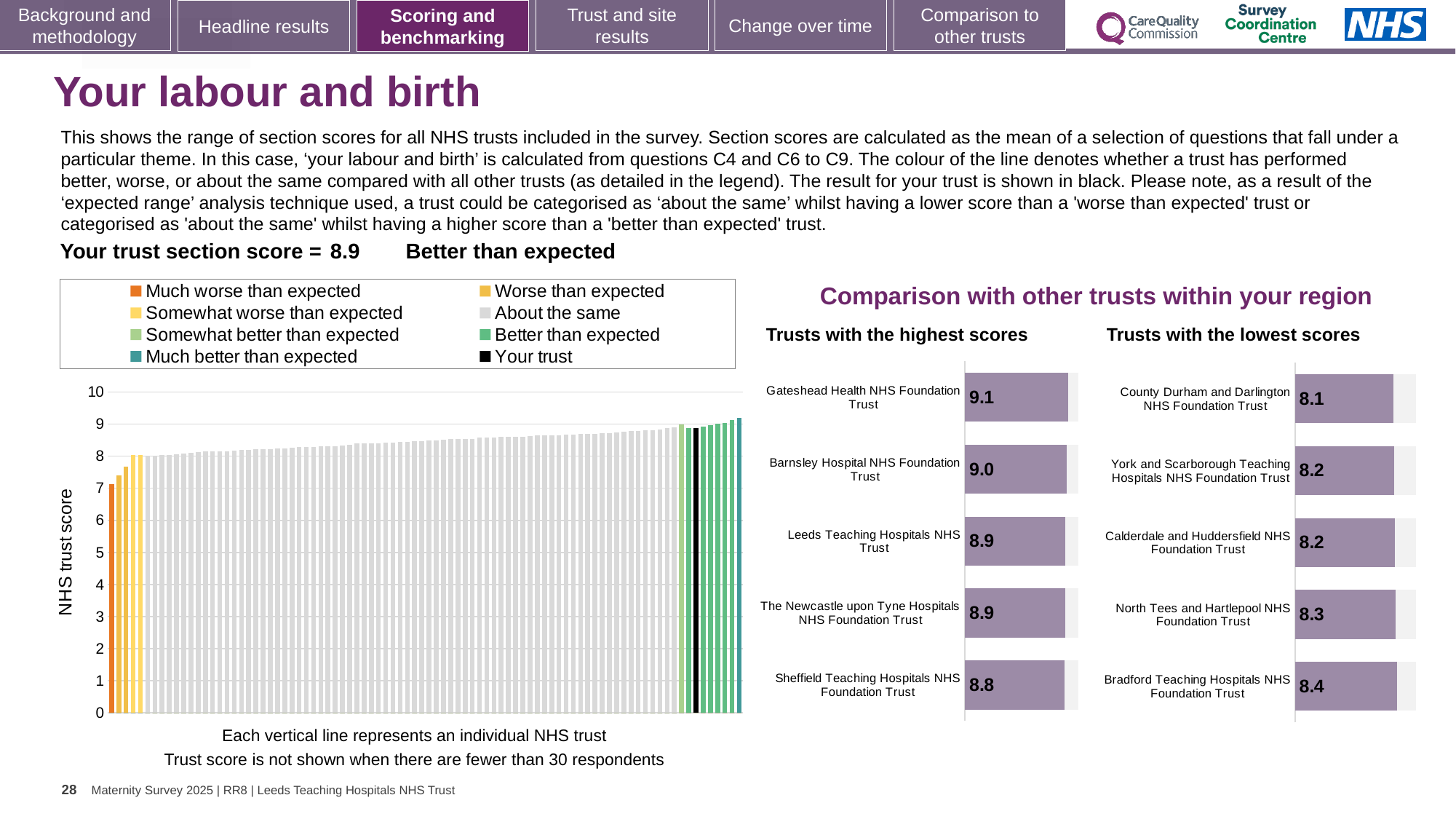
In the main chart on the left, do the trust scores rise or fall from left to right along the x axis? Rise In the 'Trusts with the lowest scores' chart, which trust has the lowest score? County Durham and Darlington NHS Foundation Trust In the 'Trusts with the highest scores' chart, which trust has the highest score? Gateshead Health NHS Foundation Trust In the 'Trusts with the lowest scores' chart, what is the score for Bradford Teaching Hospitals NHS Foundation Trust? 8.4 In the 'Trusts with the highest scores' chart, what is the difference between the scores of Gateshead Health NHS Foundation Trust and Sheffield Teaching Hospitals NHS Foundation Trust? 0.3 In the 'Trusts with the highest scores' chart, what is the score for Gateshead Health NHS Foundation Trust? 9.1 In the main chart on the left, is the value of the tallest bar greater or less than 9? greater What kind of chart is the main chart on the left showing all NHS trusts? Bar chart How many trusts are shown in the 'Trusts with the lowest scores' chart? 5 In the 'Trusts with the lowest scores' chart, which has the larger score: North Tees and Hartlepool NHS Foundation Trust or County Durham and Darlington NHS Foundation Trust? North Tees and Hartlepool NHS Foundation Trust How many entries does the legend of the main chart on the left list? 8 What is the y-axis label of the main chart on the left? NHS trust score